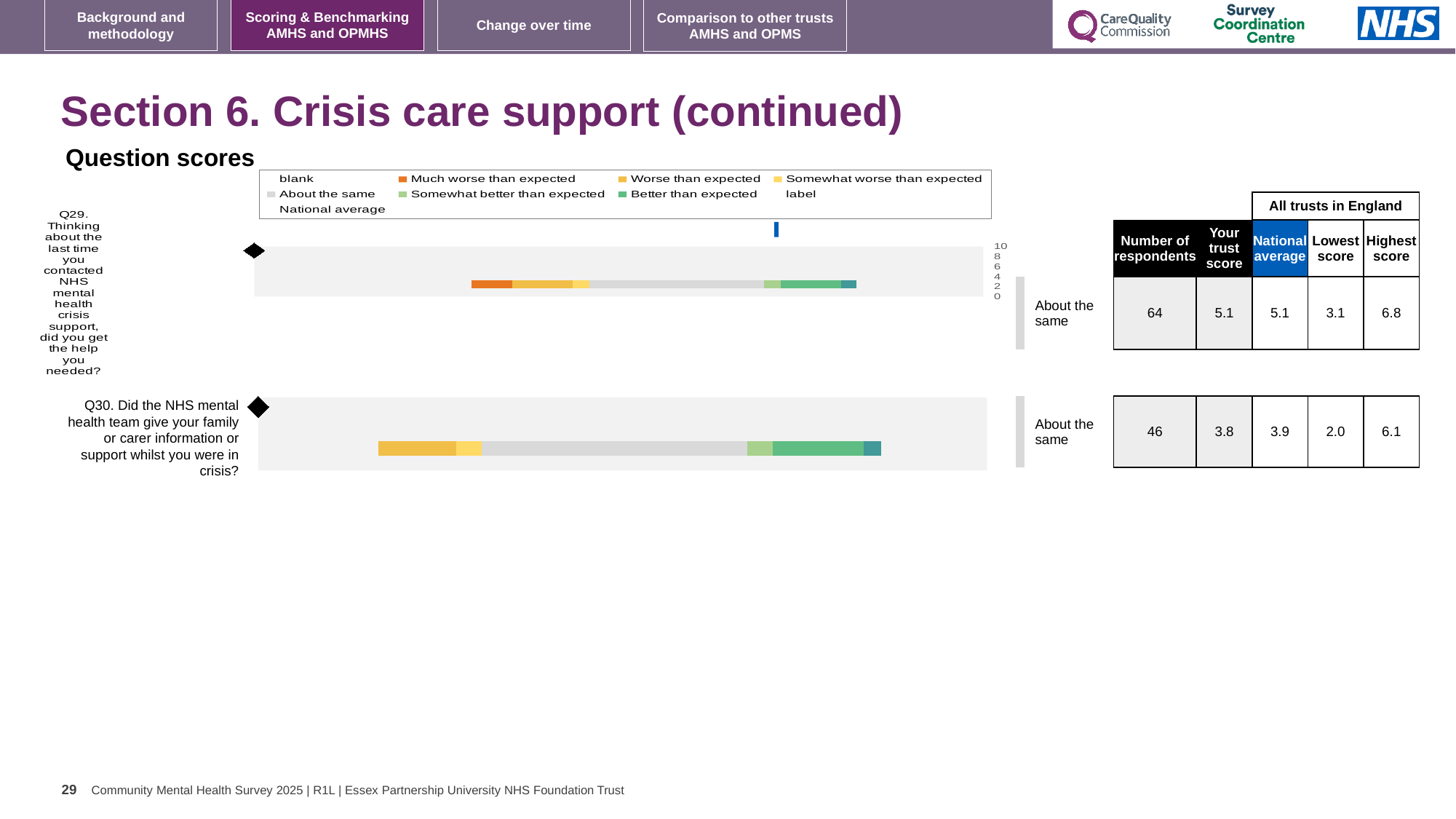
What is the 'Your trust score' value for Q30? 3.8 What colour represents 'Much worse than expected' in the legend? orange What is the difference in the number of respondents between Q29 and Q30? 18 How many entries does the legend of the question scores chart list? 9 What is the national average for Q30? 3.9 What is the 'Your trust score' value for Q29? 5.1 What is the number of respondents for Q29? 64 What is the highest score across all trusts in England for Q29? 6.8 What is the difference between the 'Your trust score' for Q29 and Q30? 1.3 How many questions (bars) are plotted in the question scores chart? 2 Which question has the larger 'Your trust score', Q29 or Q30? Q29 What kind of chart is used to show the question scores on this slide? bar chart